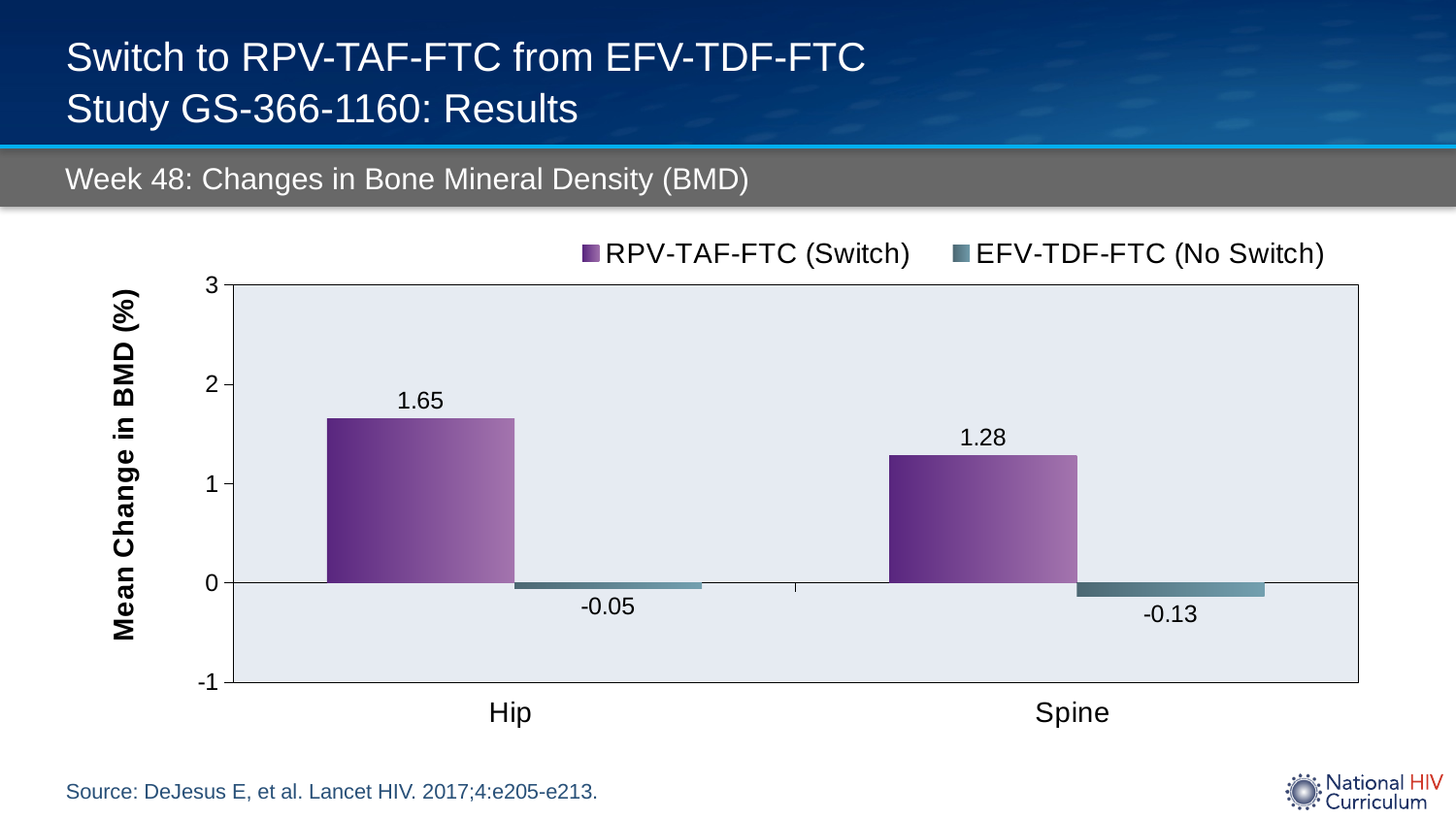
Which category has the highest value for RPV-TAF-FTC (Switch)? Hip Which is larger at the Spine: the RPV-TAF-FTC (Switch) value or the EFV-TDF-FTC (No Switch) value? RPV-TAF-FTC (Switch) How many categories are shown on the x axis? 2 How many series does the legend list? 2 What is the mean change in BMD for EFV-TDF-FTC (No Switch) at the Hip? -0.05 What is the difference between the RPV-TAF-FTC (Switch) values at the Hip and the Spine? 0.37 What is the mean change in BMD for EFV-TDF-FTC (No Switch) at the Spine? -0.13 Is the RPV-TAF-FTC (Switch) value at the Hip greater or less than 2? less What is the mean change in BMD for RPV-TAF-FTC (Switch) at the Spine? 1.28 What kind of chart is shown on the slide? bar chart What is the mean change in BMD for RPV-TAF-FTC (Switch) at the Hip? 1.65 Which category has the lowest value for EFV-TDF-FTC (No Switch)? Spine